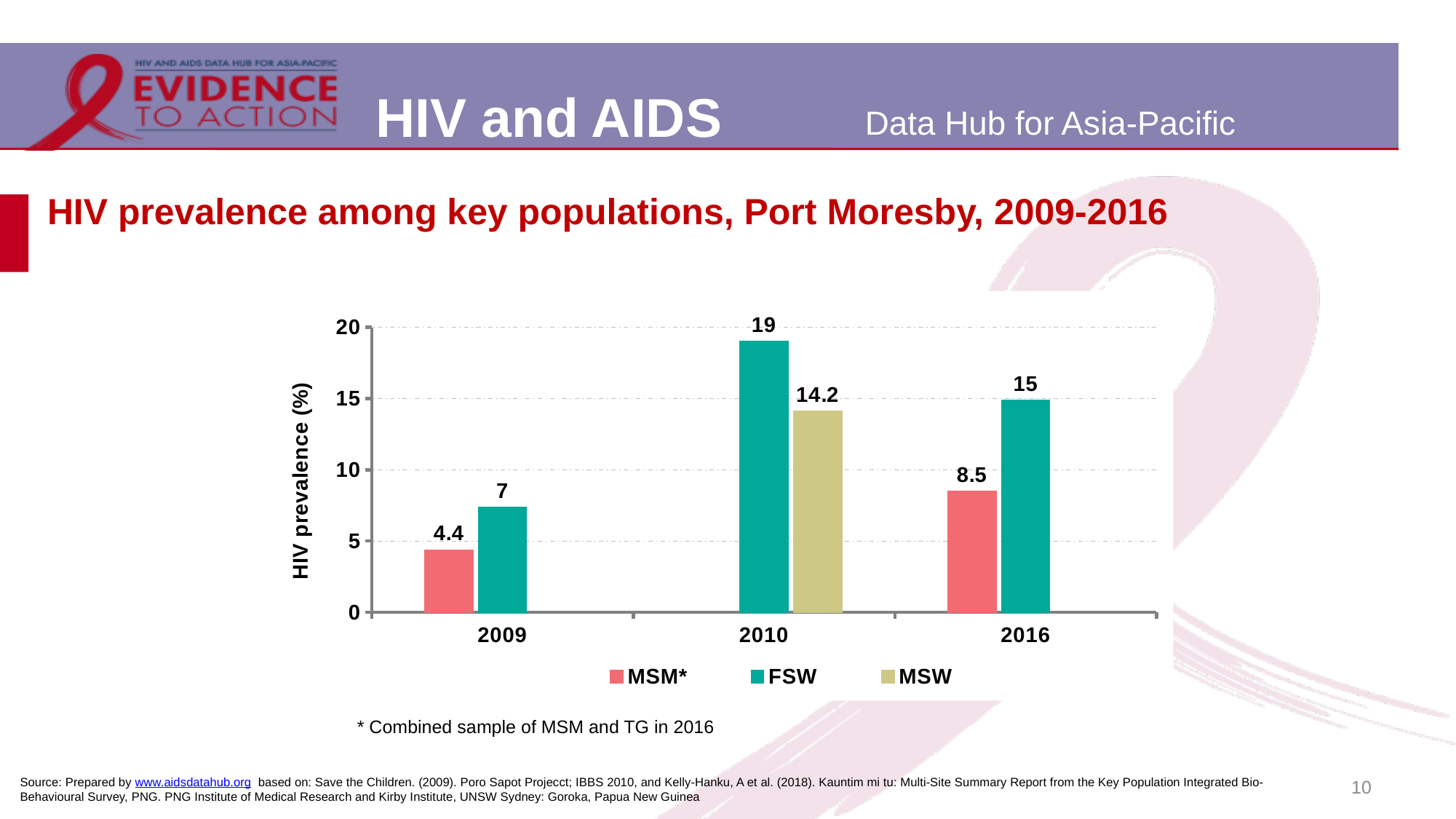
What is the HIV prevalence among FSW in 2010? 19 What is the HIV prevalence among MSW in 2010? 14.2 What is the difference between the FSW and MSW HIV prevalence in 2010? 4.8 What is the HIV prevalence among MSM* in 2016? 8.5 What is the difference between the FSW and MSM* HIV prevalence in 2016? 6.5 What is the HIV prevalence among MSM* in 2009? 4.4 Which group has the lowest HIV prevalence in 2009? MSM* How does the HIV prevalence among MSM* change from 2009 to 2016? It rises Which is larger in 2016, the HIV prevalence among MSM* or among FSW? FSW How many series does the legend list? 3 In which year is the FSW HIV prevalence highest? 2010 What kind of chart is shown on the slide? Bar chart